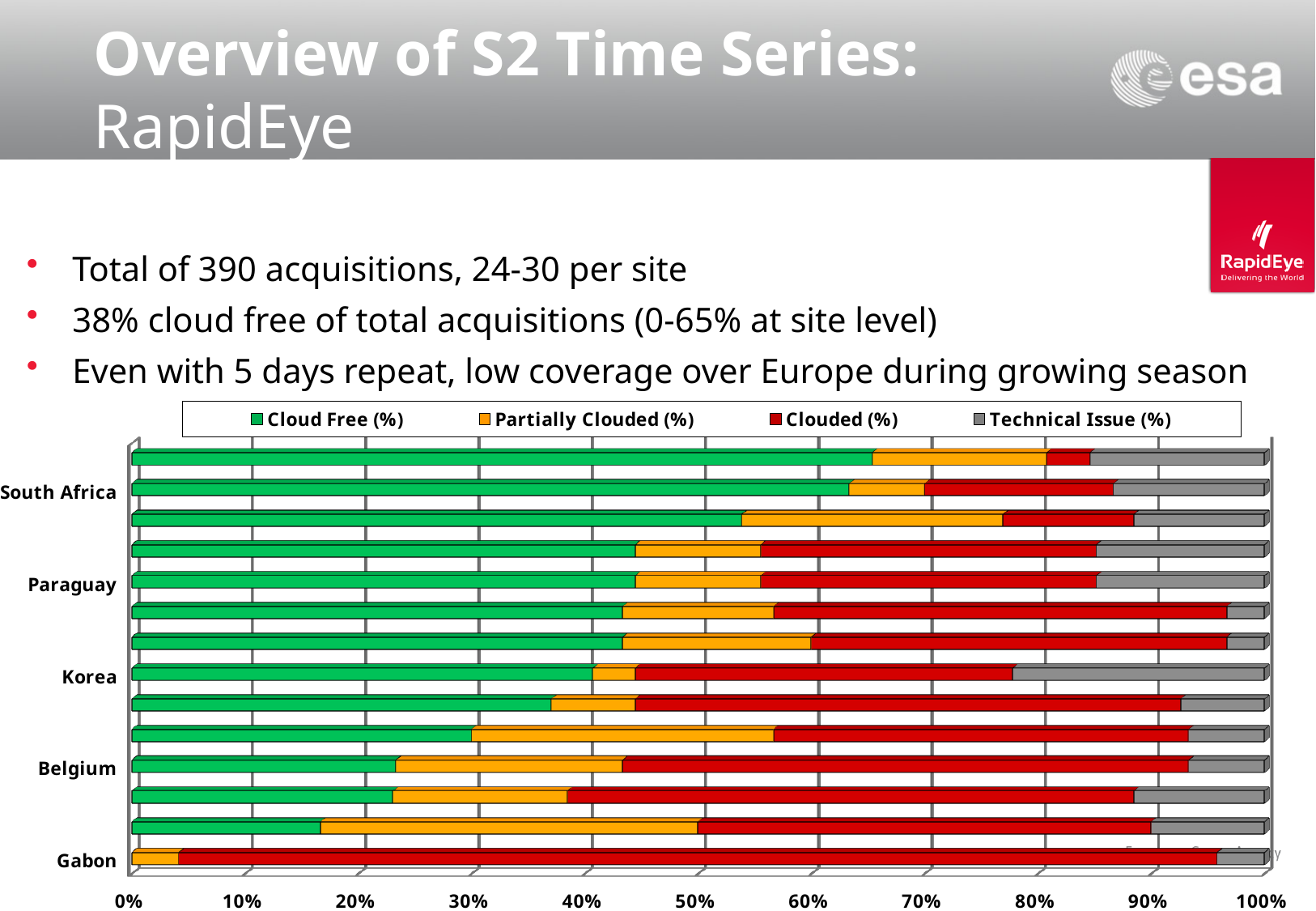
How many series does the chart legend list? 4 What kind of chart is shown on the slide? stacked bar chart Is the Clouded (%) value for Gabon greater or less than 80%? greater Is the Cloud Free (%) value for Korea greater or less than 50%? less Which series is shown in green in the chart? Cloud Free (%) Among the labelled sites, which has the lowest Cloud Free (%) value? Gabon Is the Cloud Free (%) value for South Africa greater or less than 50%? greater Which series is shown in grey in the chart? Technical Issue (%) Which has the larger Cloud Free (%) value, Belgium or Korea? Korea Among the labelled sites, which has the highest Cloud Free (%) value? South Africa